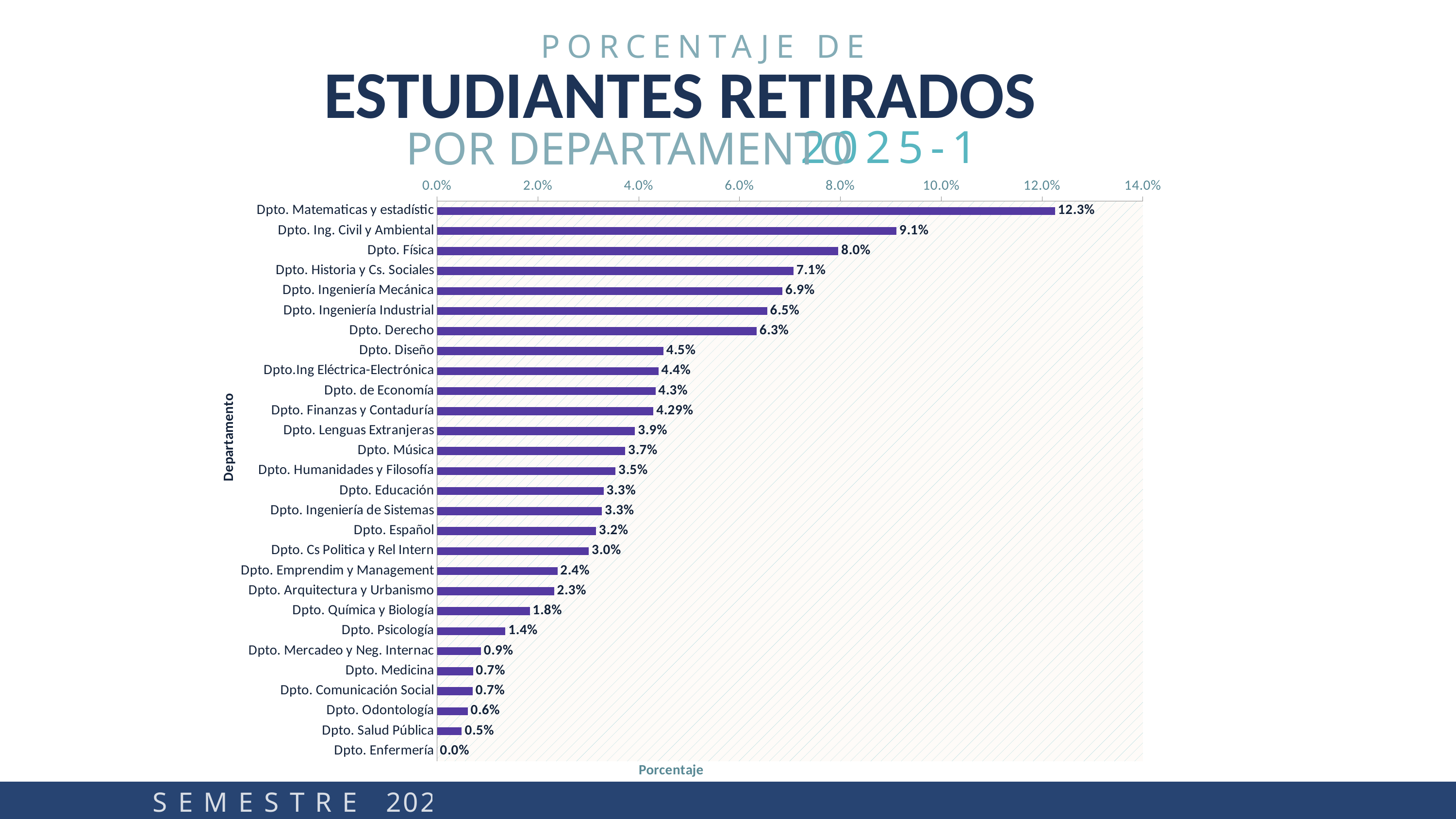
Which department has the highest percentage? Dpto. Matematicas y estadístic What is the difference between Dpto. Ing. Civil y Ambiental and Dpto. Física? 1.1% Which is larger, the value for Dpto. Diseño or the value for Dpto. Música? Dpto. Diseño What is the value for Dpto. Finanzas y Contaduría? 4.29% What is the label of the horizontal axis? Porcentaje Is the value for Dpto. Historia y Cs. Sociales greater or less than 6.0%? greater What is the value for Dpto. Matematicas y estadístic? 12.3% What kind of chart is shown on the slide? bar chart What is the value for Dpto. Derecho? 6.3% How many departments are shown in the chart? 28 What is the value for Dpto. Psicología? 1.4% Which department has the lowest percentage? Dpto. Enfermería